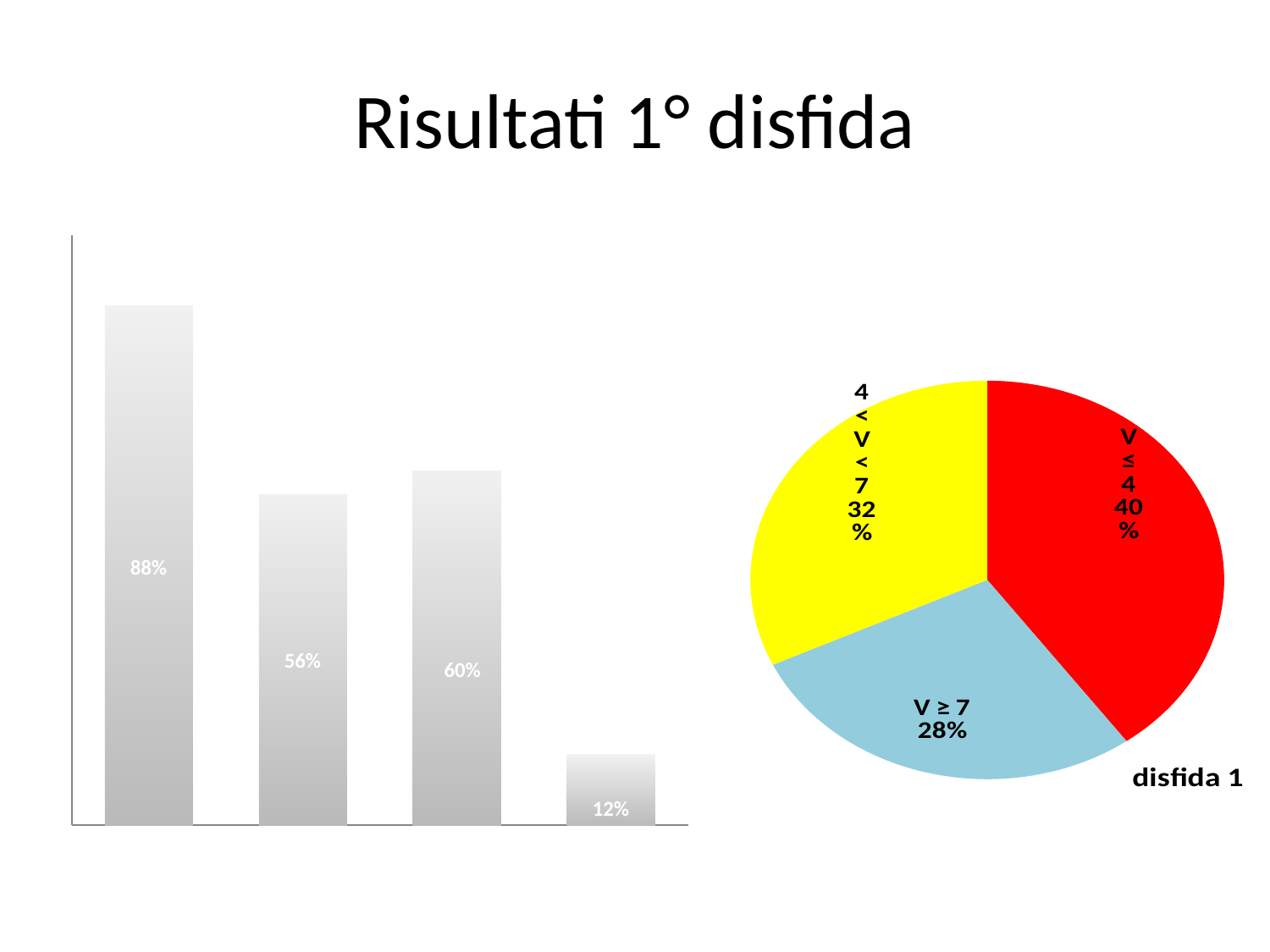
In the bar chart on the left, what is the difference between the first bar and the second bar? 32% In the bar chart on the left, how many bars are plotted? 4 In the pie chart on the right, which slice is the largest? V ≤ 4 In the bar chart on the left, what is the value of the first bar from the left? 88% In the pie chart on the right, which slice is the smallest? V ≥ 7 In the pie chart on the right, what share does the slice V ≥ 7 have? 28% In the pie chart on the right, how many slices are there? 3 In the pie chart on the right, what colour is the slice for 4 < V < 7? yellow In the bar chart on the left, what is the value of the last bar on the right? 12% What kind of chart is the chart on the right of the slide? pie chart What kind of chart is the chart on the left of the slide? bar chart In the bar chart on the left, which is larger, the second bar or the third bar? the third bar (60%)